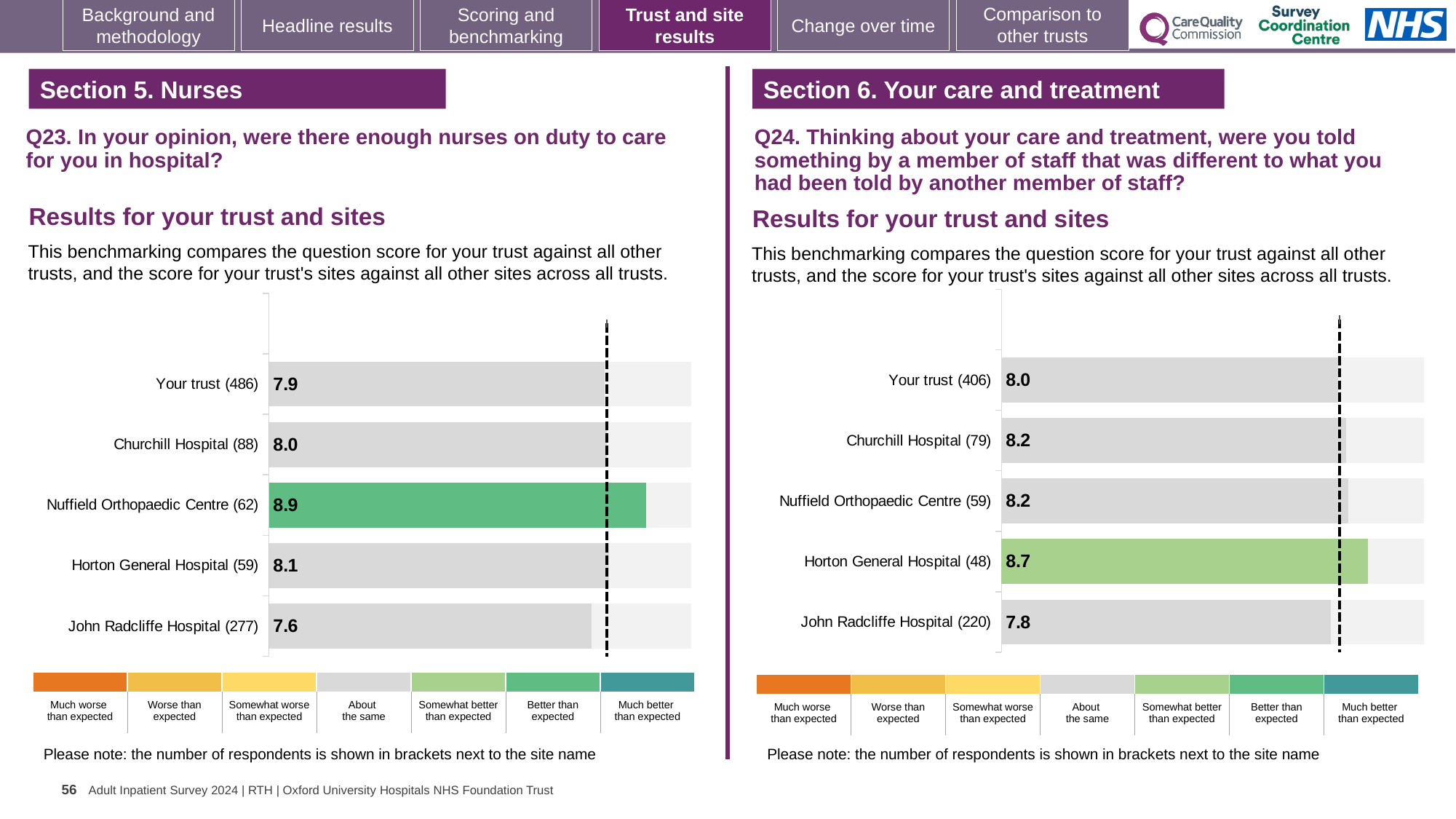
On the Q23 chart (left), what is the difference between the scores for Nuffield Orthopaedic Centre and John Radcliffe Hospital? 1.3 On the Q24 chart (right), what is the score for John Radcliffe Hospital? 7.8 What kind of chart is used on the Q23 chart (left)? Bar chart On the Q24 chart (right), which is larger: the score for Your trust or the score for Churchill Hospital? Churchill Hospital On the Q24 chart (right), how many respondents are shown in brackets for Your trust? 406 On the Q23 chart (left), which site has the lowest score? John Radcliffe Hospital On the Q24 chart (right), which site has the highest score? Horton General Hospital On the Q23 chart (left), what is the score for Your trust? 7.9 On the Q24 chart (right), what is the score for Horton General Hospital? 8.7 On the Q23 chart (left), how many bars are plotted? 5 On the Q23 chart (left), what is the score for Nuffield Orthopaedic Centre? 8.9 On the Q24 chart (right), what is the difference between the scores for Horton General Hospital and Your trust? 0.7